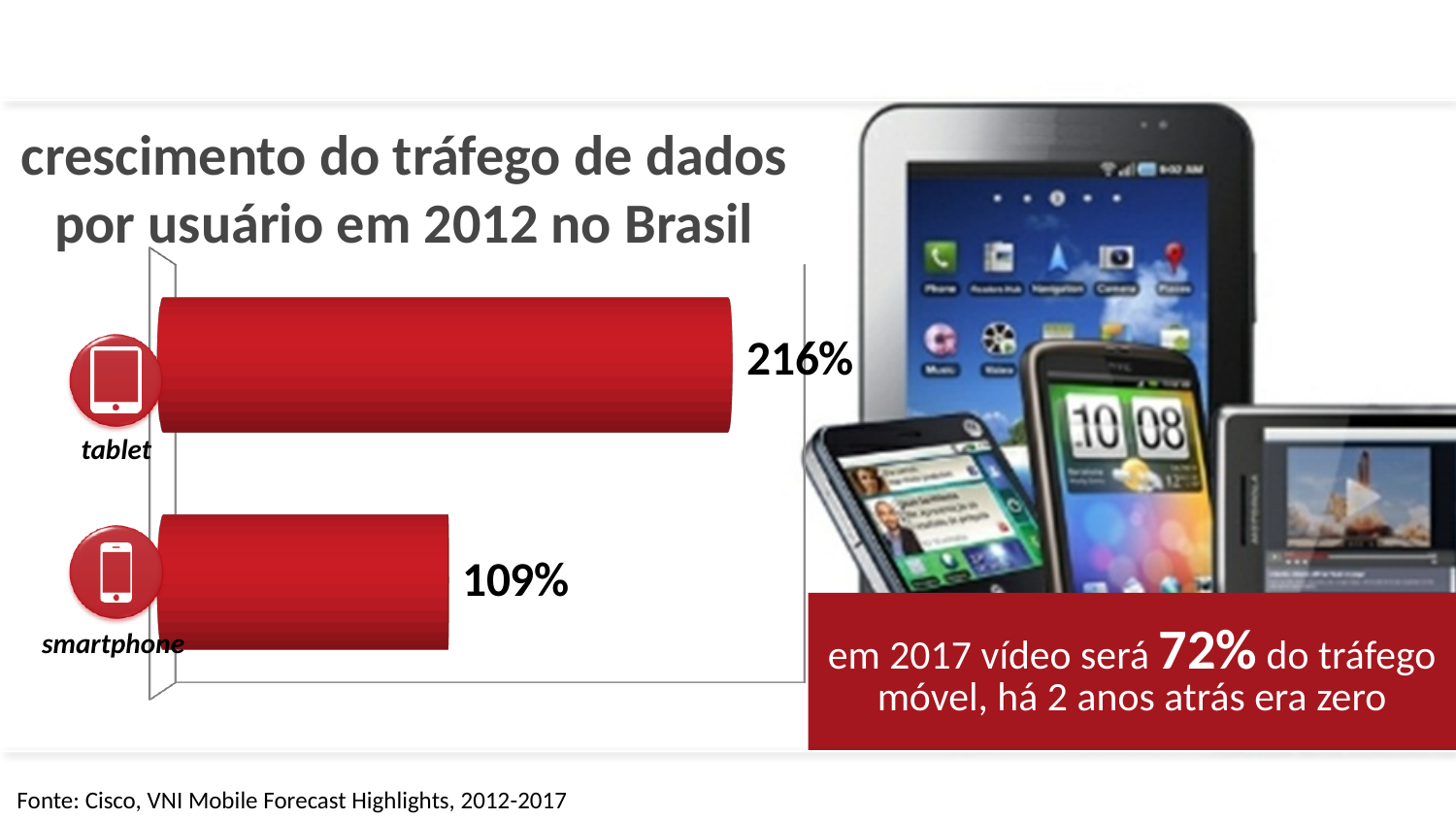
What kind of chart is shown on the slide? bar chart How many categories are shown in the chart? 2 Which is larger, the value for tablet or the value for smartphone? tablet What is the value for smartphone? 109% Which category has the highest value? tablet What colour are the bars in the chart? red What is the title of the chart? crescimento do tráfego de dados por usuário em 2012 no Brasil What is the difference between the tablet and smartphone values? 107% Which category has the lowest value? smartphone What is the value for tablet? 216%